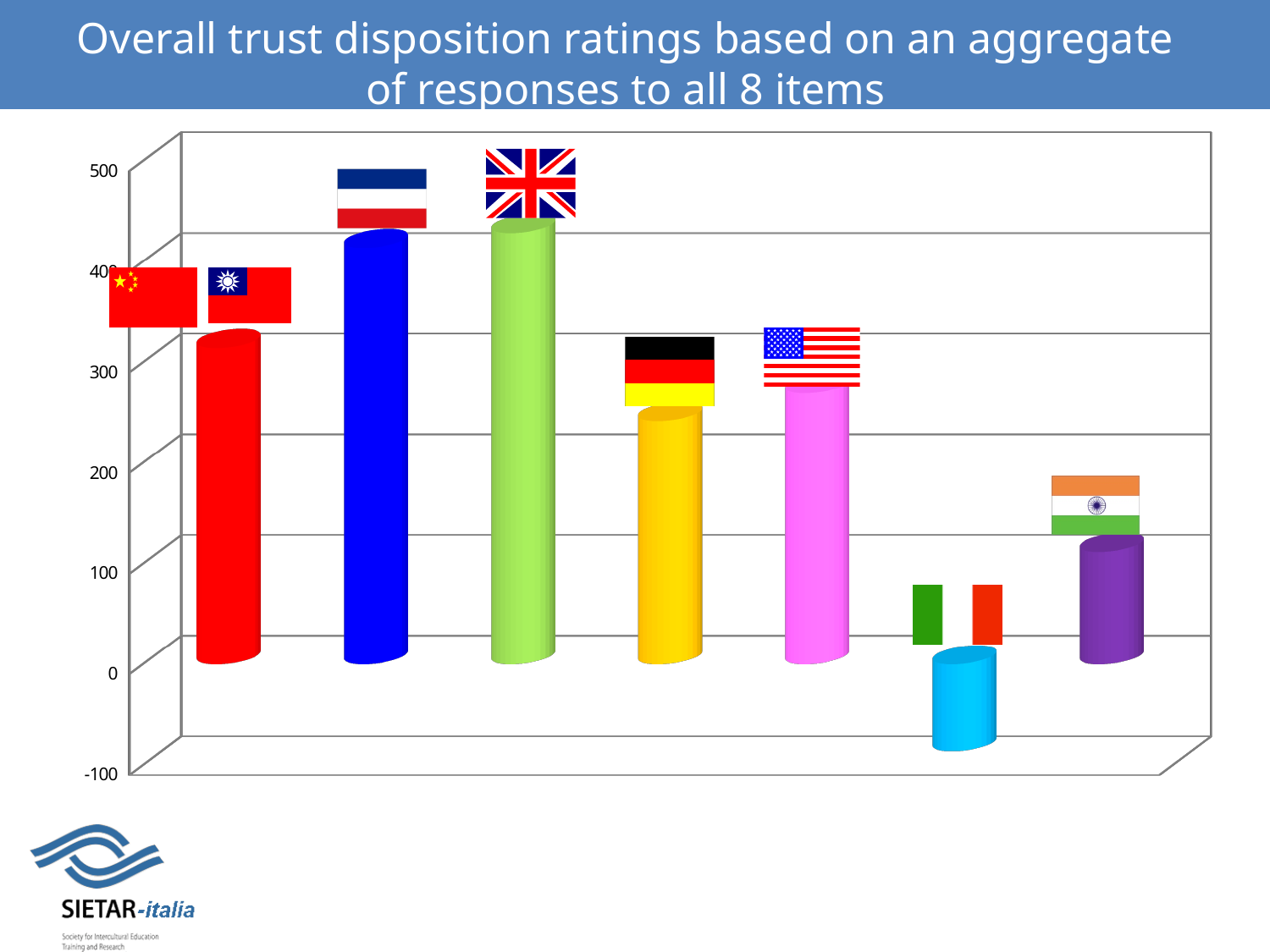
Which is larger: the bar under the Indian flag or the bar under the US flag? the bar under the US flag Is the value for the bar under the UK flag greater or less than 400? greater Is the value for the bar under the Italian flag greater or less than 0? less Is the value for the bar under the German flag greater or less than 300? less Which country's bar is the lowest in the chart? Italy What is the title of the chart on the slide? Overall trust disposition ratings based on an aggregate of responses to all 8 items Which is larger: the bar under the Chinese and Taiwanese flags or the bar under the German flag? the bar under the Chinese and Taiwanese flags What kind of chart is shown on the slide? bar chart How many bars (countries) are plotted in the chart? 7